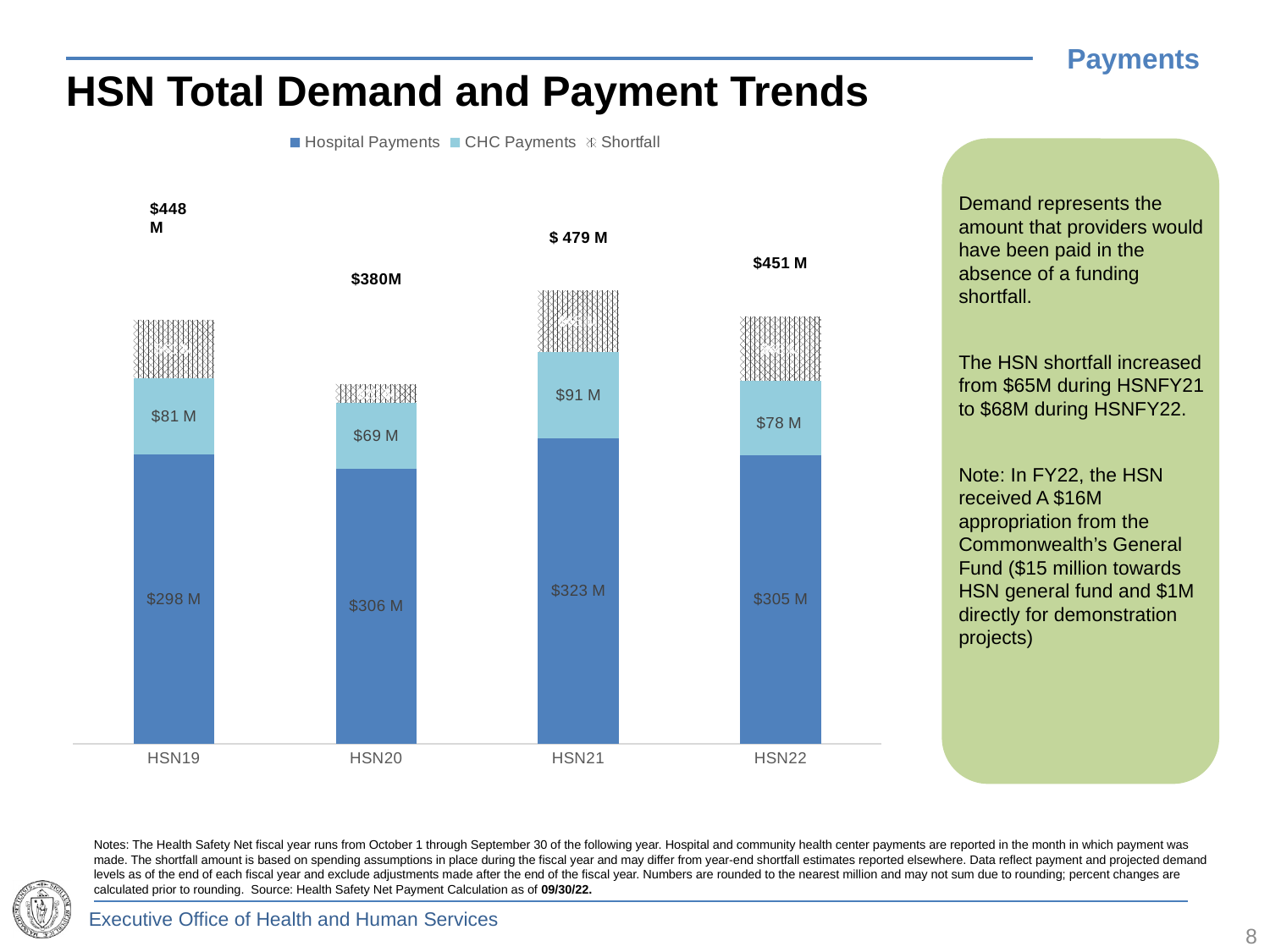
Which is larger, the CHC Payments for HSN19 or for HSN22? HSN19 How many fiscal years are shown on the x axis? 4 What is the Hospital Payments value for HSN20? $306 M What is the title of the chart? HSN Total Demand and Payment Trends What is the CHC Payments value for HSN20? $69 M What is the difference between the Hospital Payments for HSN21 and HSN19? $25 M How many series does the legend list? 3 What is the total demand labeled above the HSN22 bar? $451 M Which fiscal year has the lowest total demand shown above its bar? HSN20 What is the Hospital Payments value for HSN21? $323 M Which fiscal year has the highest total demand shown above its bar? HSN21 What kind of chart is shown on the slide? Stacked bar chart